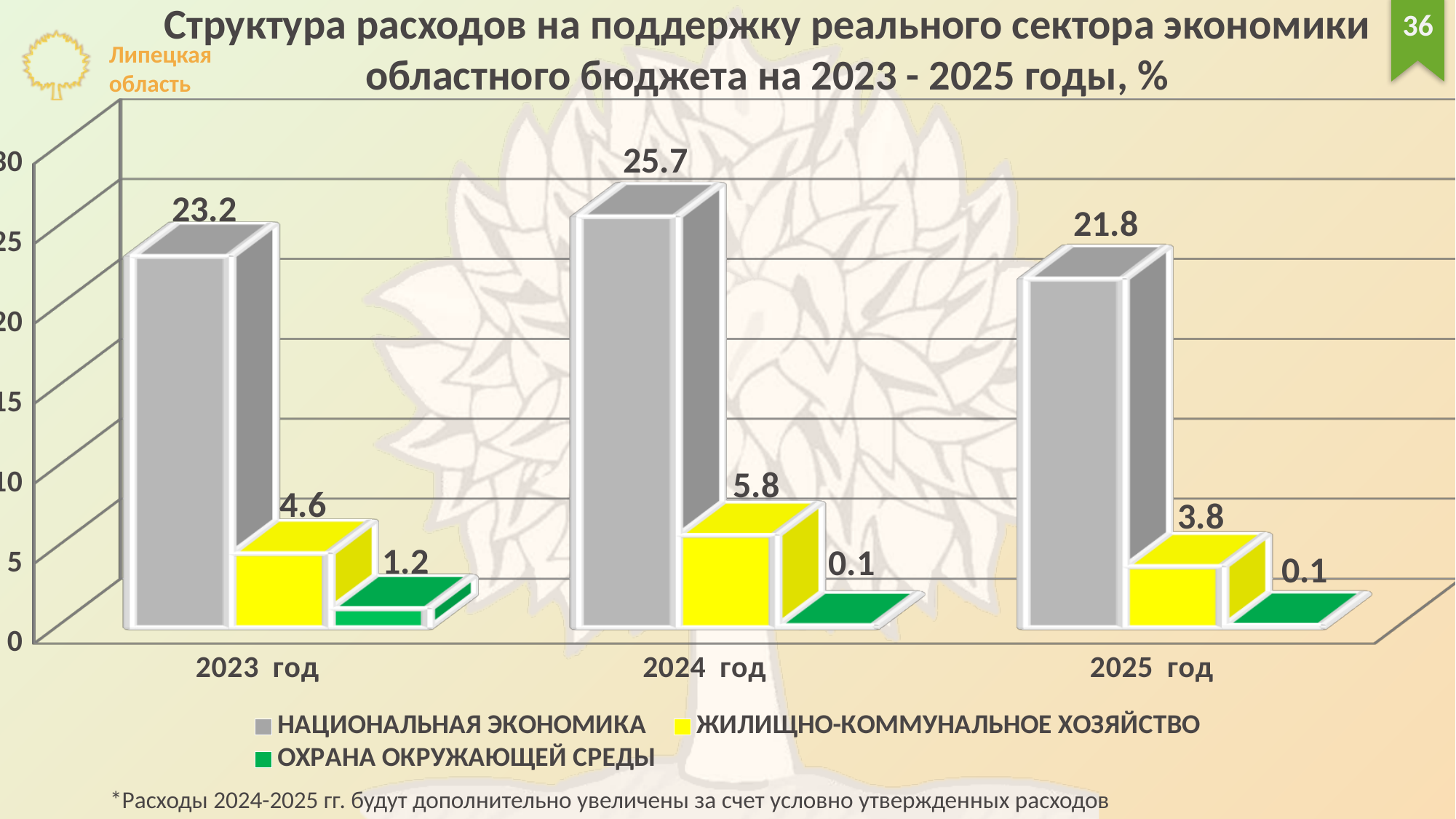
Which is larger: ЖИЛИЩНО-КОММУНАЛЬНОЕ ХОЗЯЙСТВО in 2024 год or in 2023 год? 2024 год What is the difference between the НАЦИОНАЛЬНАЯ ЭКОНОМИКА values for 2024 год and 2025 год? 3.9 Is the value for НАЦИОНАЛЬНАЯ ЭКОНОМИКА in 2023 год greater or less than 20? greater In which year is the value for ЖИЛИЩНО-КОММУНАЛЬНОЕ ХОЗЯЙСТВО lowest? 2025 год How many years are shown on the x axis? 3 Which colour represents ОХРАНА ОКРУЖАЮЩЕЙ СРЕДЫ in the legend? green What kind of chart is shown on the slide? bar chart In which year is the value for НАЦИОНАЛЬНАЯ ЭКОНОМИКА highest? 2024 год What is the value for ОХРАНА ОКРУЖАЮЩЕЙ СРЕДЫ in 2025 год? 0.1 What is the value for НАЦИОНАЛЬНАЯ ЭКОНОМИКА in 2024 год? 25.7 How many series does the legend list? 3 What is the value for ЖИЛИЩНО-КОММУНАЛЬНОЕ ХОЗЯЙСТВО in 2023 год? 4.6